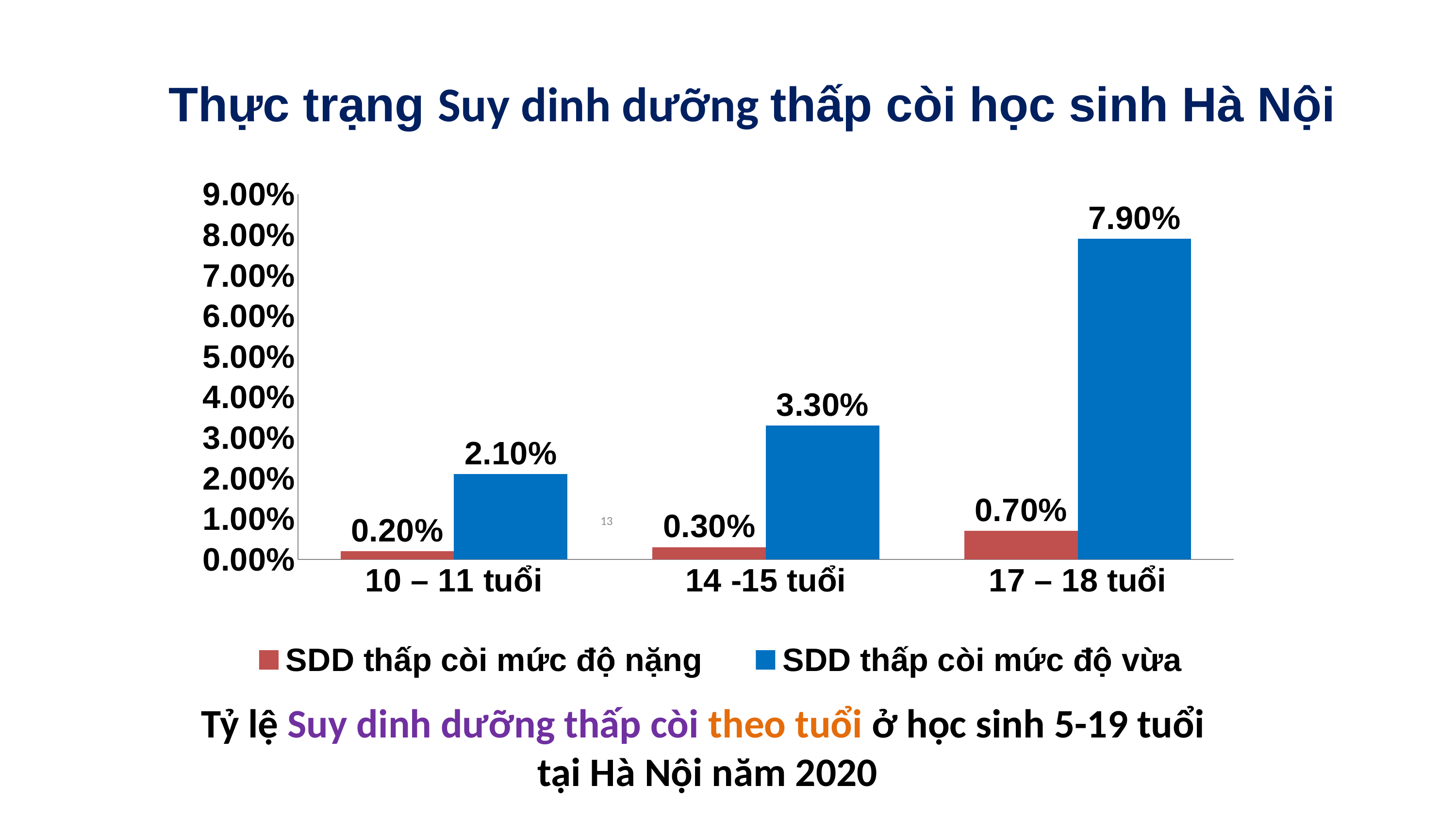
Which age group has the highest value for SDD thấp còi mức độ vừa? 17 – 18 tuổi What is the value of SDD thấp còi mức độ nặng for 10 – 11 tuổi? 0.20% What kind of chart is shown on the slide? Bar chart Which age group has the lowest value for SDD thấp còi mức độ nặng? 10 – 11 tuổi What is the value of SDD thấp còi mức độ nặng for 17 – 18 tuổi? 0.70% Do the values for SDD thấp còi mức độ vừa rise or fall from 10 – 11 tuổi to 17 – 18 tuổi? Rise What is the value of SDD thấp còi mức độ vừa for 17 – 18 tuổi? 7.90% Which is larger: SDD thấp còi mức độ vừa for 10 – 11 tuổi or SDD thấp còi mức độ nặng for 17 – 18 tuổi? SDD thấp còi mức độ vừa for 10 – 11 tuổi What is the value of SDD thấp còi mức độ vừa for 14 -15 tuổi? 3.30% How many series does the legend list? 2 What is the difference between SDD thấp còi mức độ vừa for 17 – 18 tuổi and for 14 -15 tuổi? 4.60% How many age groups are shown on the x axis? 3